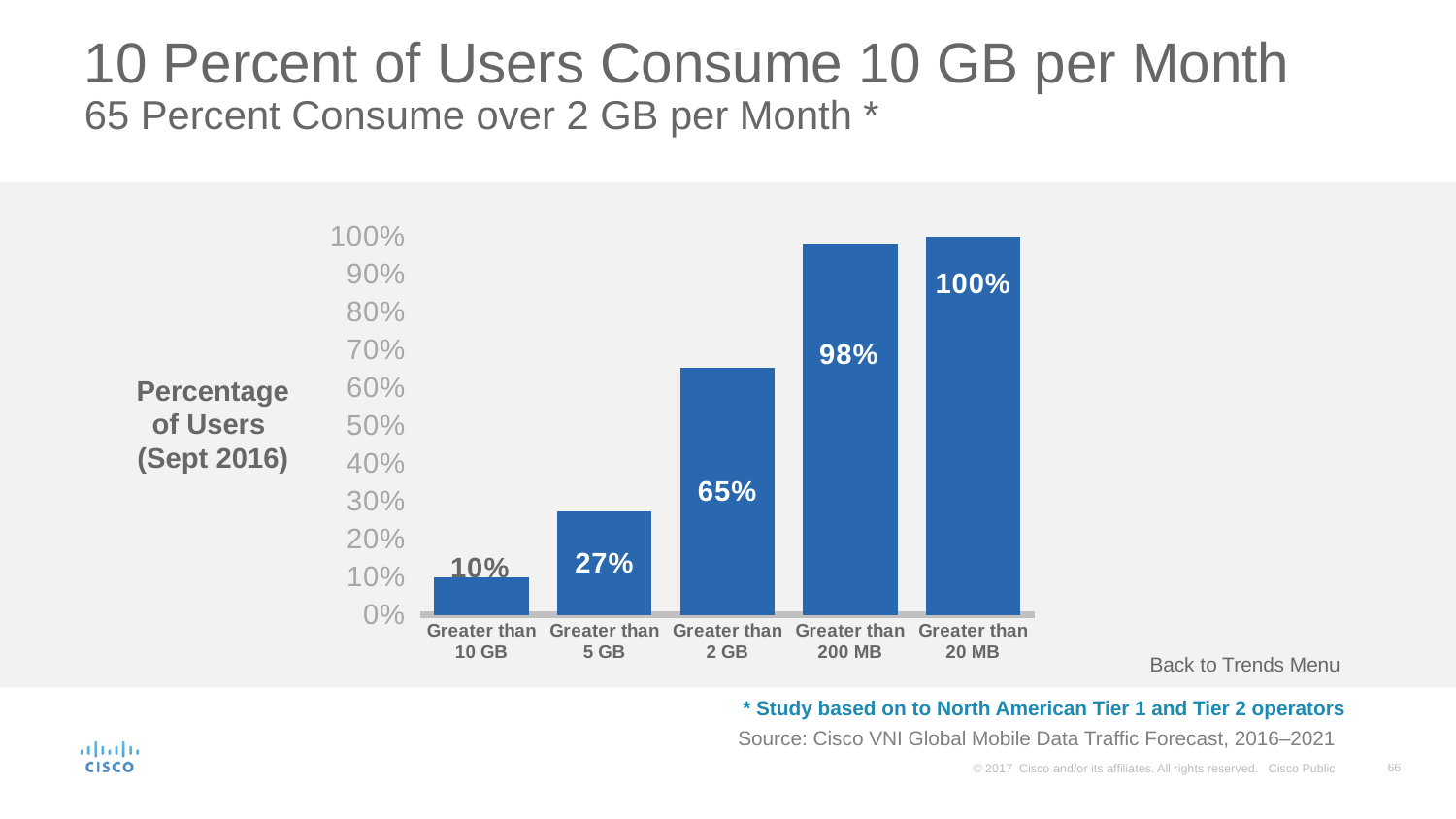
Which is larger: the value for 'Greater than 200 MB' or 'Greater than 2 GB'? Greater than 200 MB What percentage of users consume greater than 10 GB per month? 10% What percentage of users consume greater than 200 MB per month? 98% Which category has the highest percentage of users? Greater than 20 MB How many categories are shown on the x axis? 5 What is the label of the y axis? Percentage of Users (Sept 2016) What percentage of users consume greater than 2 GB per month? 65% Do the values rise or fall moving from left to right along the x axis? Rise Which category has the lowest percentage of users? Greater than 10 GB What kind of chart is shown on the slide? Bar chart What is the difference in percentage points between the 'Greater than 2 GB' and 'Greater than 5 GB' bars? 38 What percentage of users consume greater than 5 GB per month? 27%